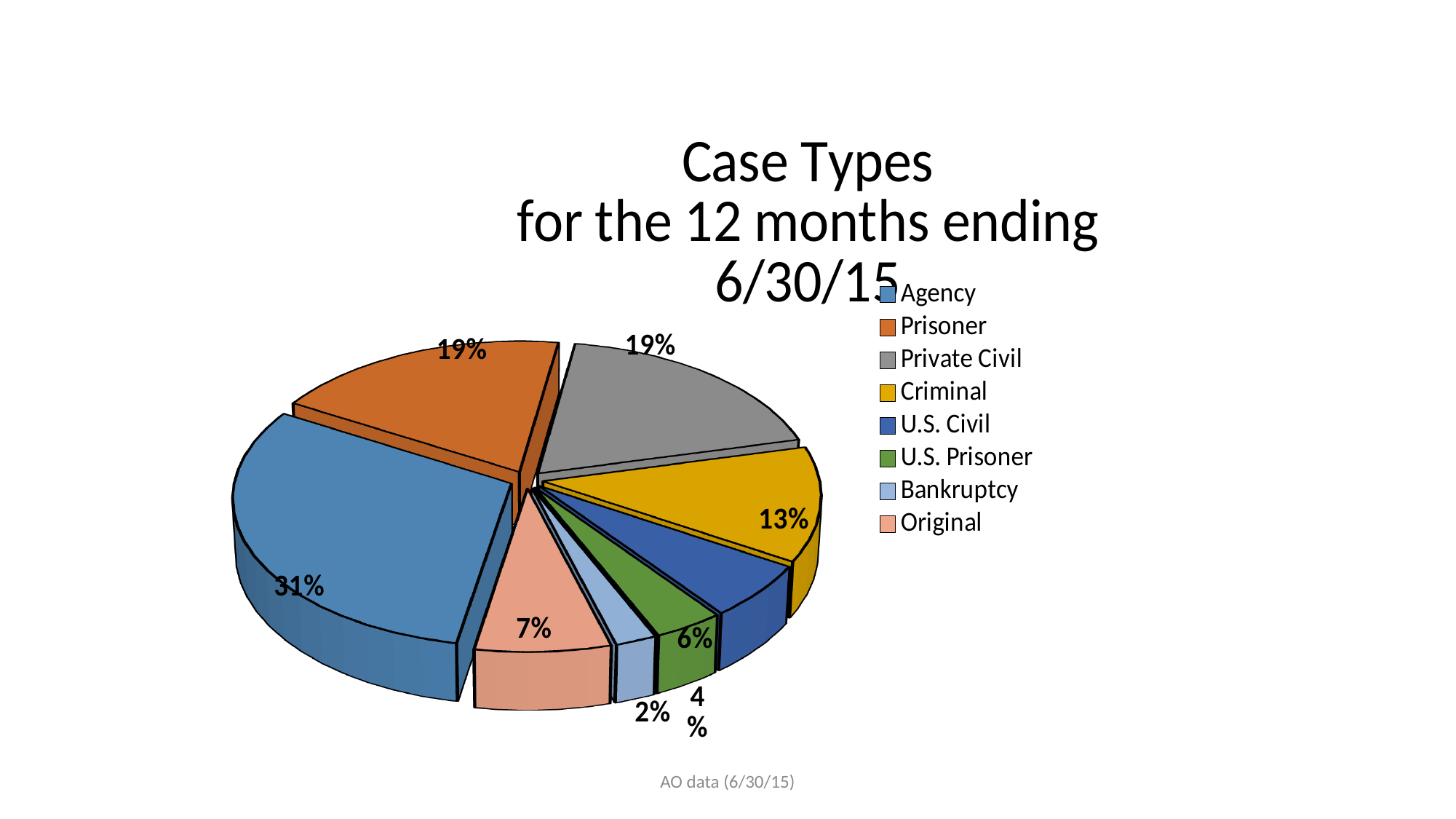
What share of cases is Original? 7% What is the difference in percentage points between the Agency share and the Criminal share? 18 What share of cases is Private Civil? 19% What share of cases is Bankruptcy? 2% Which case type has the largest share of the pie? Agency Which case type has the smallest share of the pie? Bankruptcy What is the title of the chart? Case Types for the 12 months ending 6/30/15 What share of cases is Criminal? 13% What type of chart is shown on the slide? pie chart Which is larger, the Original share or the Criminal share? Criminal How many case types does the legend list? 8 What share of cases is Agency? 31%